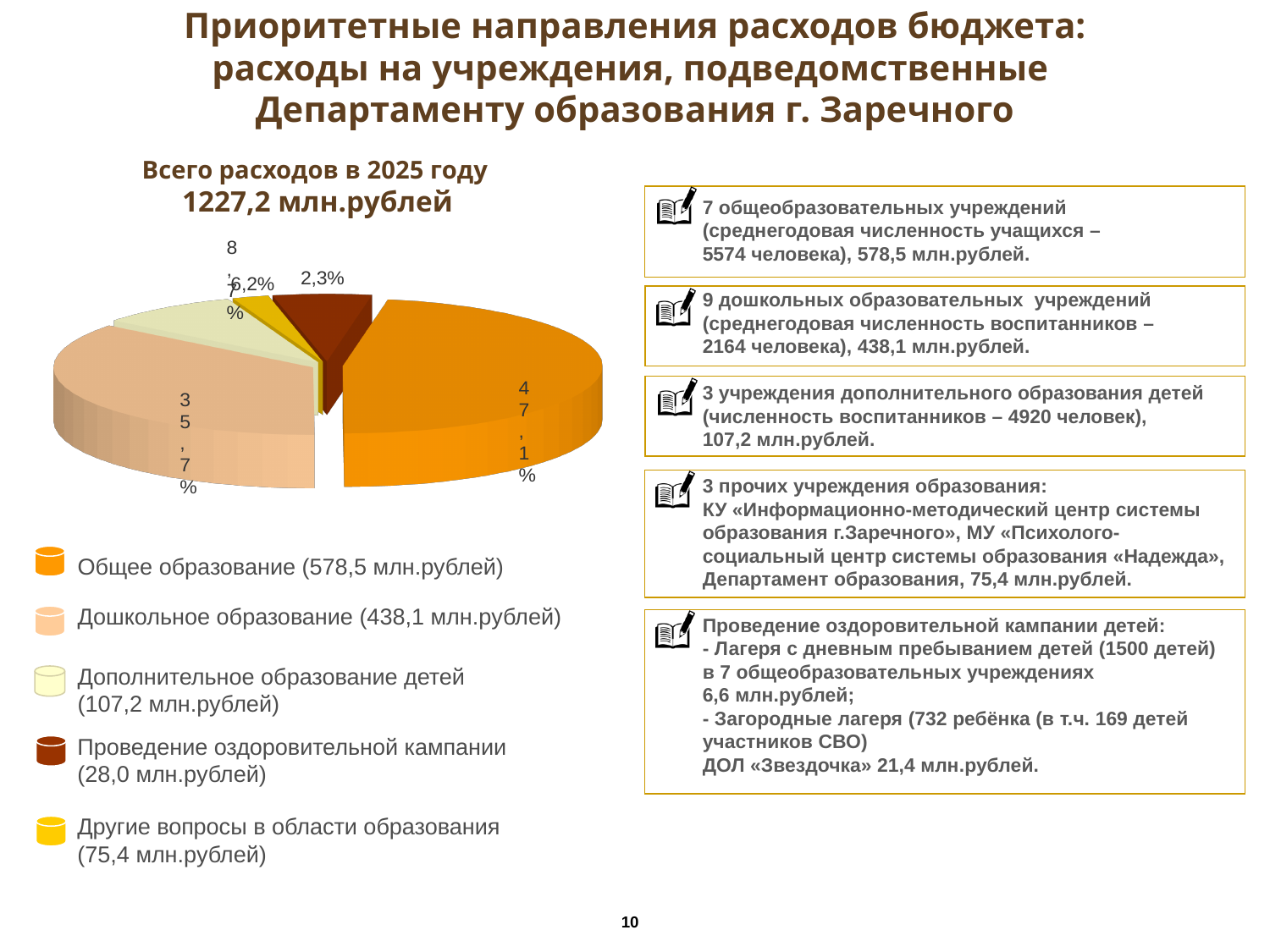
How many slices does the pie chart have? 5 What percentage share does Другие вопросы в области образования have in the pie chart? 6,2% Which is larger: the amount for Дошкольное образование or for Дополнительное образование детей? Дошкольное образование According to the legend, what is the amount for Дополнительное образование детей? 107,2 млн.рублей Which category has the largest share of the pie chart? Общее образование Which category has the smallest share of the pie chart? Проведение оздоровительной кампании What percentage share does Дошкольное образование have in the pie chart? 35,7% What percentage share does Общее образование have in the pie chart? 47,1% What is the difference between the amounts for Общее образование (578,5 млн.рублей) and Дошкольное образование (438,1 млн.рублей)? 140,4 млн.рублей According to the legend, what is the amount for Проведение оздоровительной кампании? 28,0 млн.рублей What type of chart is shown on the slide? Pie chart What total expenditure for 2025 is stated above the pie chart? 1227,2 млн.рублей